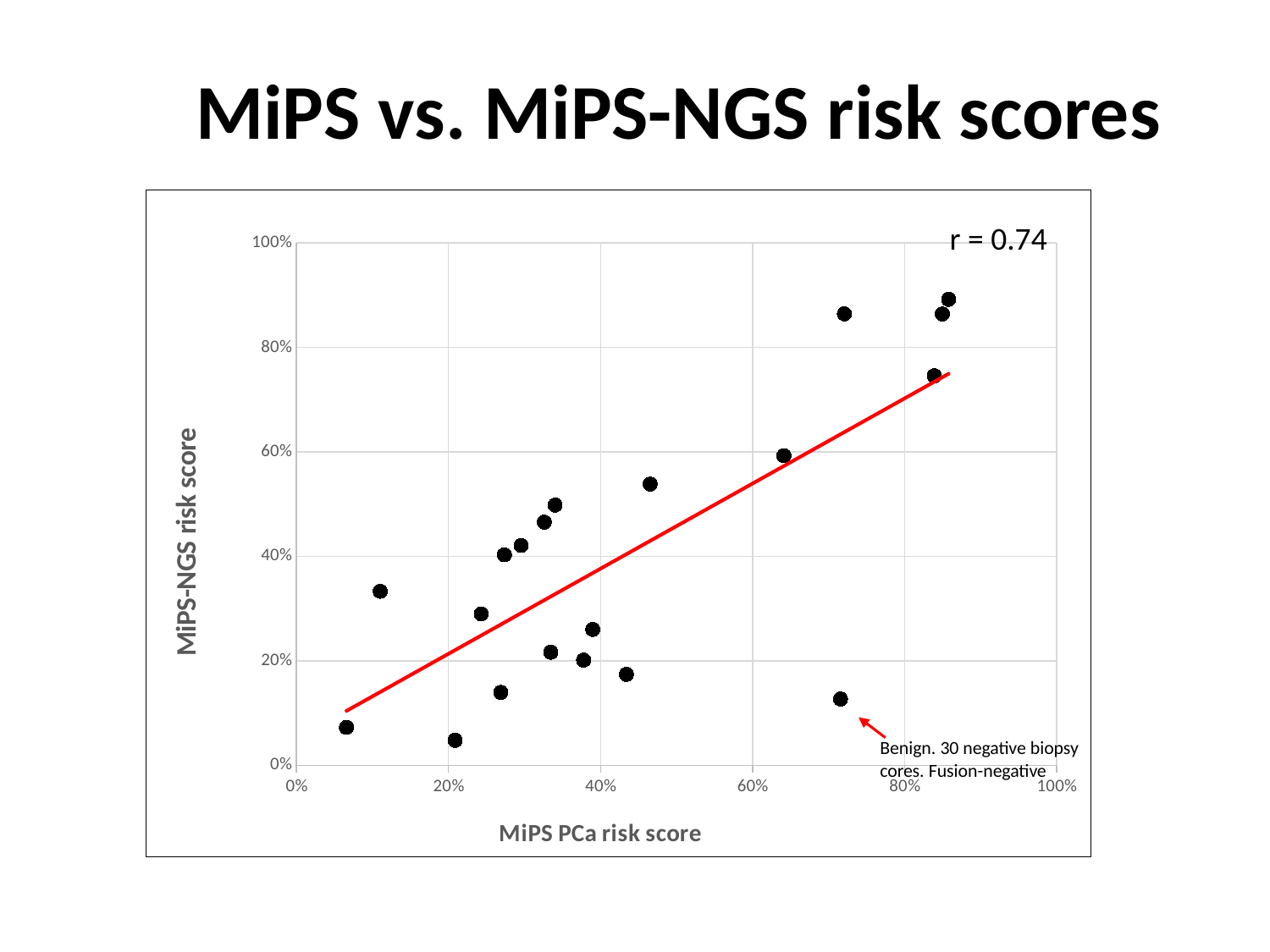
What kind of chart is shown on the slide? Scatter plot What is the label of the y axis? MiPS-NGS risk score Is the MiPS-NGS risk score of the point annotated as 'Benign. 30 negative biopsy cores. Fusion-negative' greater or less than 20%? less Is the MiPS-NGS risk score of the highest point on the chart greater or less than 80%? greater Does the red trend line rise or fall as the MiPS PCa risk score increases? Rises How many data points are plotted on the scatter chart? 20 What is the correlation coefficient r shown on the chart? r = 0.74 Is the MiPS-NGS risk score of the lowest point on the chart greater or less than 10%? less What is the title of the chart on the slide? MiPS vs. MiPS-NGS risk scores What is the label of the x axis? MiPS PCa risk score What is the maximum value shown on the y axis? 100%